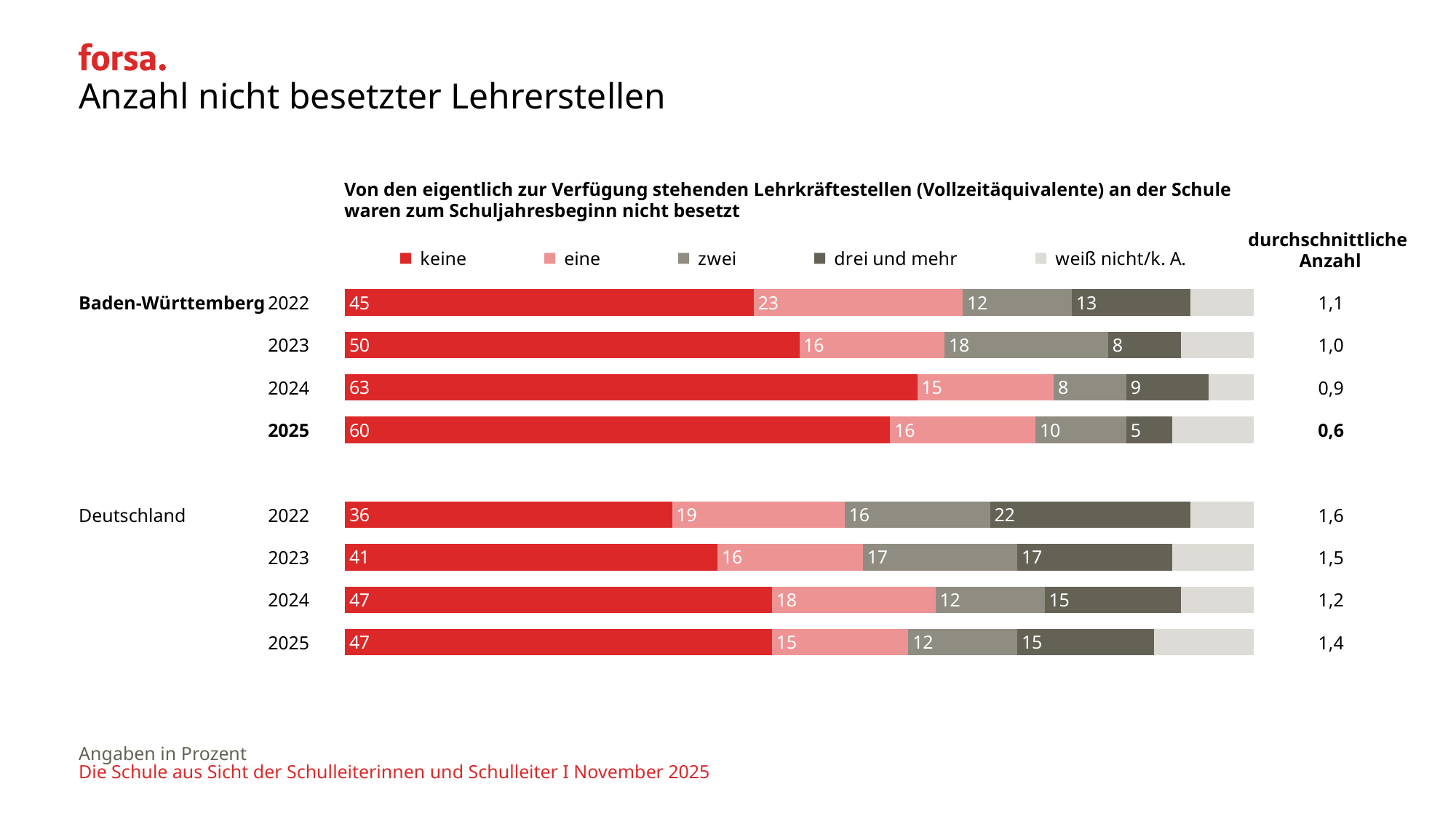
For 2025, which has the larger "keine" value: Baden-Württemberg or Deutschland? Baden-Württemberg What is the value for "drei und mehr" for Deutschland in 2022? 22 How many series does the legend list? 5 How many bars are shown in the chart? 8 In which year does Deutschland have the lowest value for "keine"? 2022 What is the "durchschnittliche Anzahl" shown for Baden-Württemberg in 2025? 0,6 What percentage of Baden-Württemberg school heads in 2022 reported "keine" unfilled teacher positions? 45 What is the difference between the "drei und mehr" values for Deutschland in 2022 and 2025? 7 What kind of chart is shown on the slide? Stacked bar chart In which year does Baden-Württemberg have the highest value for "keine"? 2024 Does the "durchschnittliche Anzahl" for Baden-Württemberg rise or fall from 2022 to 2025? Fall How much higher is the "keine" value for Baden-Württemberg in 2024 than in 2022? 18